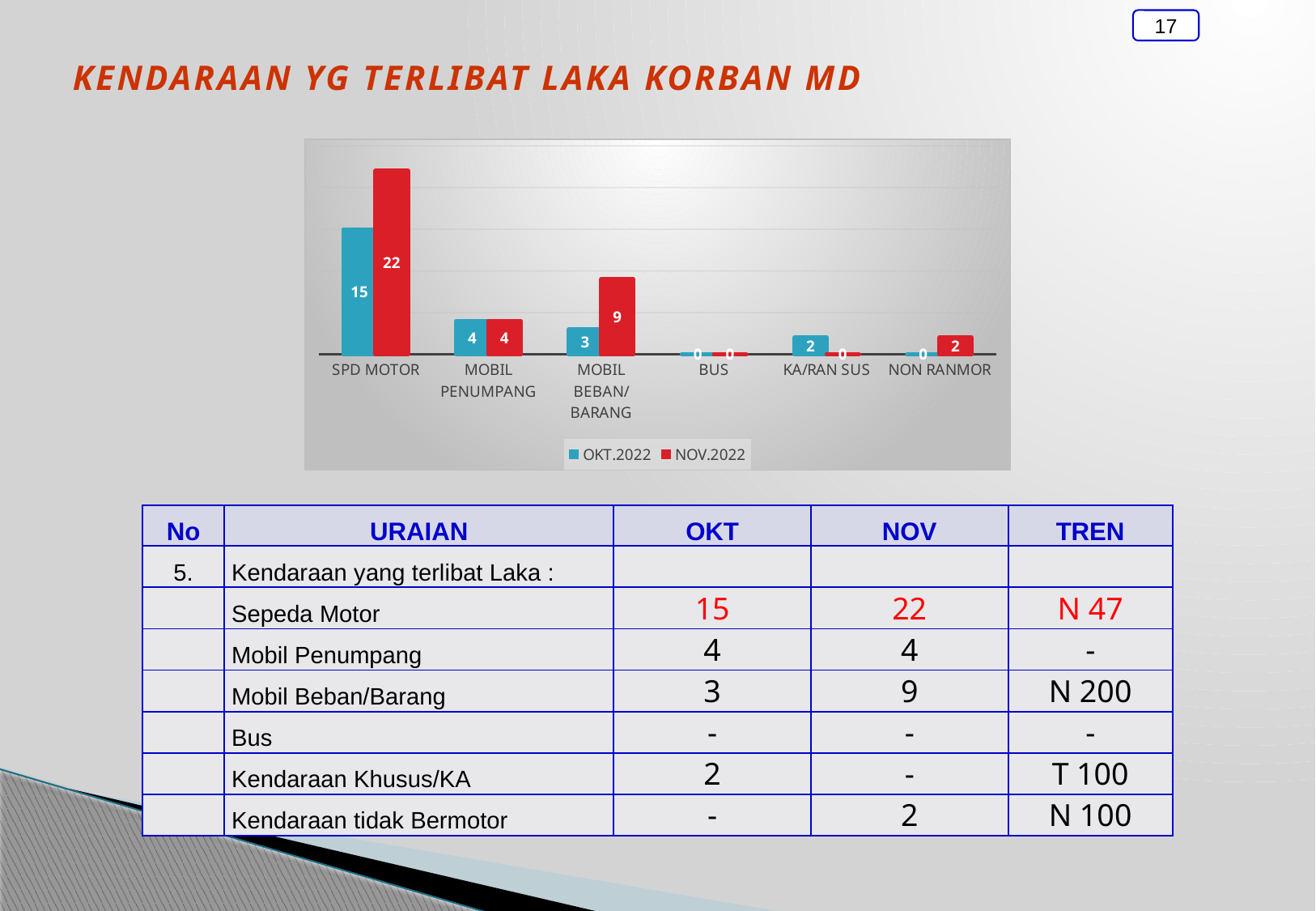
What kind of chart is shown on the slide? bar chart What is the OKT.2022 value for MOBIL BEBAN/BARANG? 3 Which category has the highest NOV.2022 value? SPD MOTOR What is the NOV.2022 value for SPD MOTOR? 22 What is the difference between the NOV.2022 and OKT.2022 values for MOBIL BEBAN/BARANG? 6 What is the NOV.2022 value for NON RANMOR? 2 What is the OKT.2022 value for BUS? 0 How many categories are shown on the x axis of the chart? 6 How many series does the legend list? 2 Which is larger for KA/RAN SUS, the OKT.2022 value or the NOV.2022 value? OKT.2022 What is the difference between the NOV.2022 and OKT.2022 values for SPD MOTOR? 7 Which colour represents the NOV.2022 series in the chart? red